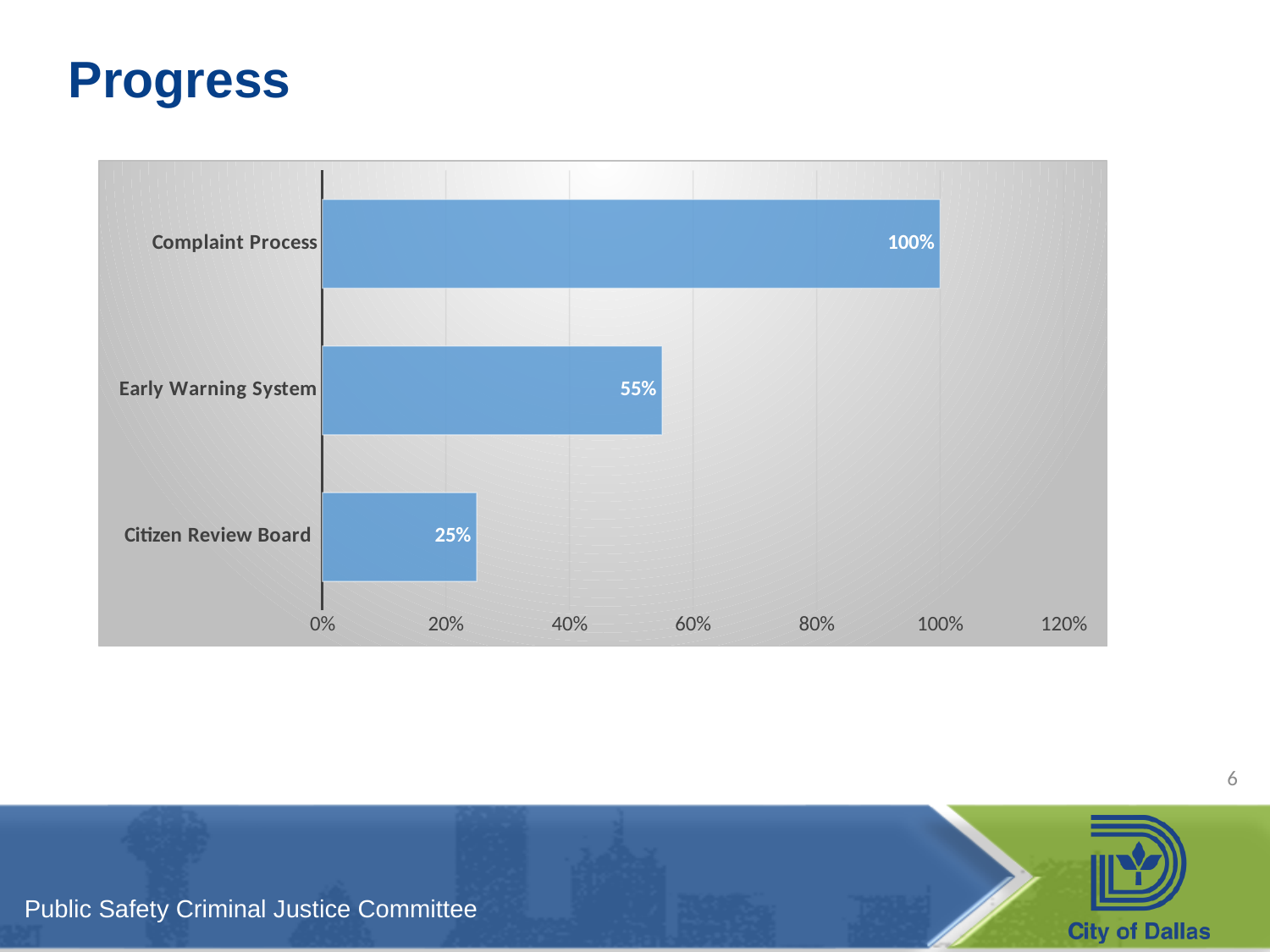
Which category has the lowest value? Citizen Review Board How many categories are shown in the chart? 3 What is the value for Complaint Process? 100% Which is larger, the value for Early Warning System or the value for Citizen Review Board? Early Warning System What is the highest value shown on the x axis? 120% What kind of chart is shown on the slide? bar chart What is the value for Citizen Review Board? 25% What is the difference between the values for Early Warning System and Citizen Review Board? 30% What is the value for Early Warning System? 55% Is the value for Early Warning System greater or less than 40%? greater What is the difference between the values for Complaint Process and Early Warning System? 45% Which category has the highest value? Complaint Process